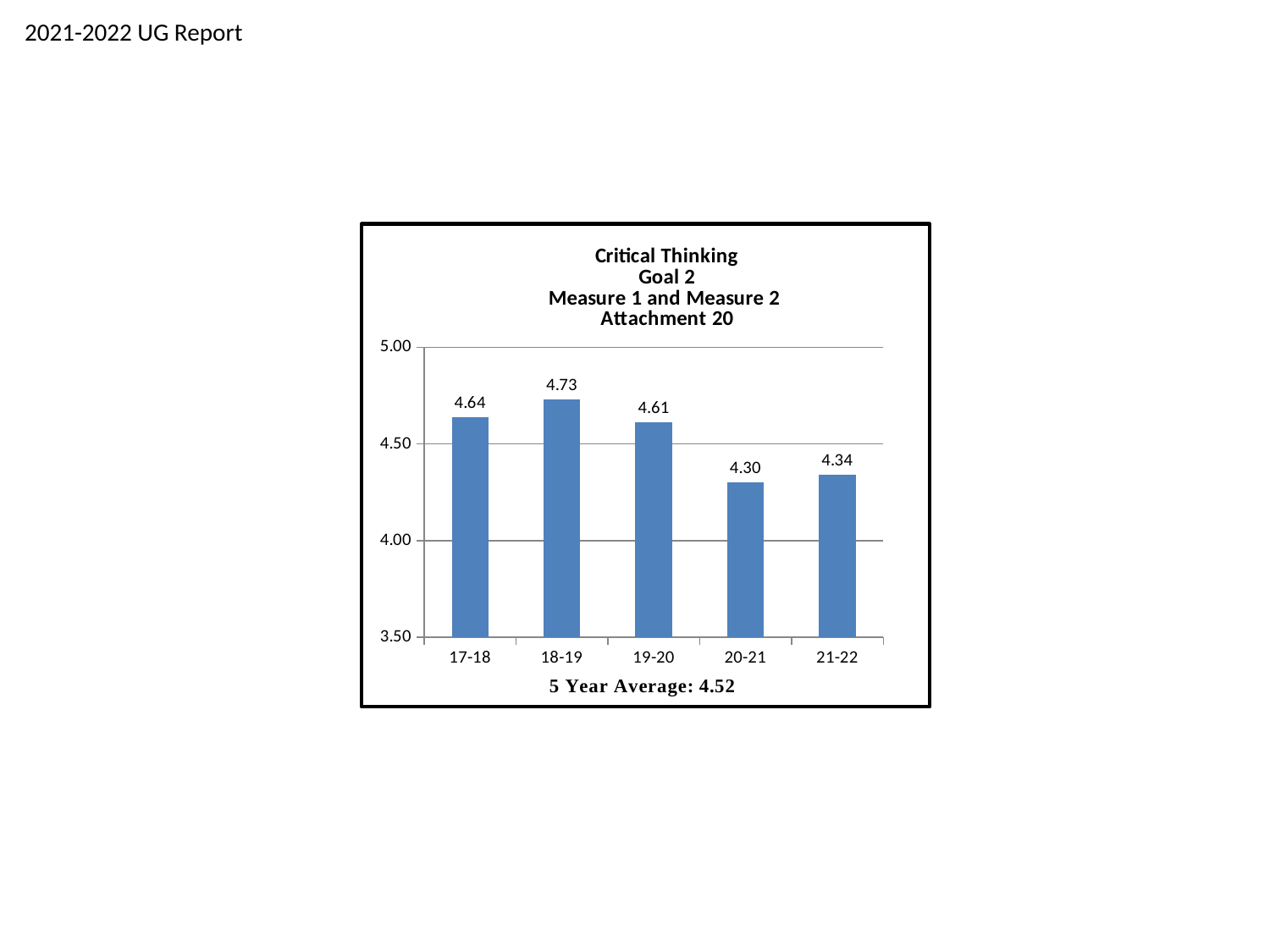
Which is larger, the value for 19-20 or the value for 21-22? 19-20 What is the difference between the values for 17-18 and 20-21? 0.34 How many years are shown on the x axis? 5 What is the value for 20-21? 4.30 Which year has the lowest value? 20-21 Which year has the highest value? 18-19 Is the value for 20-21 greater or less than 4.50? less What is the difference between the values for 18-19 and 19-20? 0.12 What 5 year average is stated below the chart? 4.52 What is the value for 21-22? 4.34 What kind of chart is shown? bar chart What is the value for 17-18? 4.64